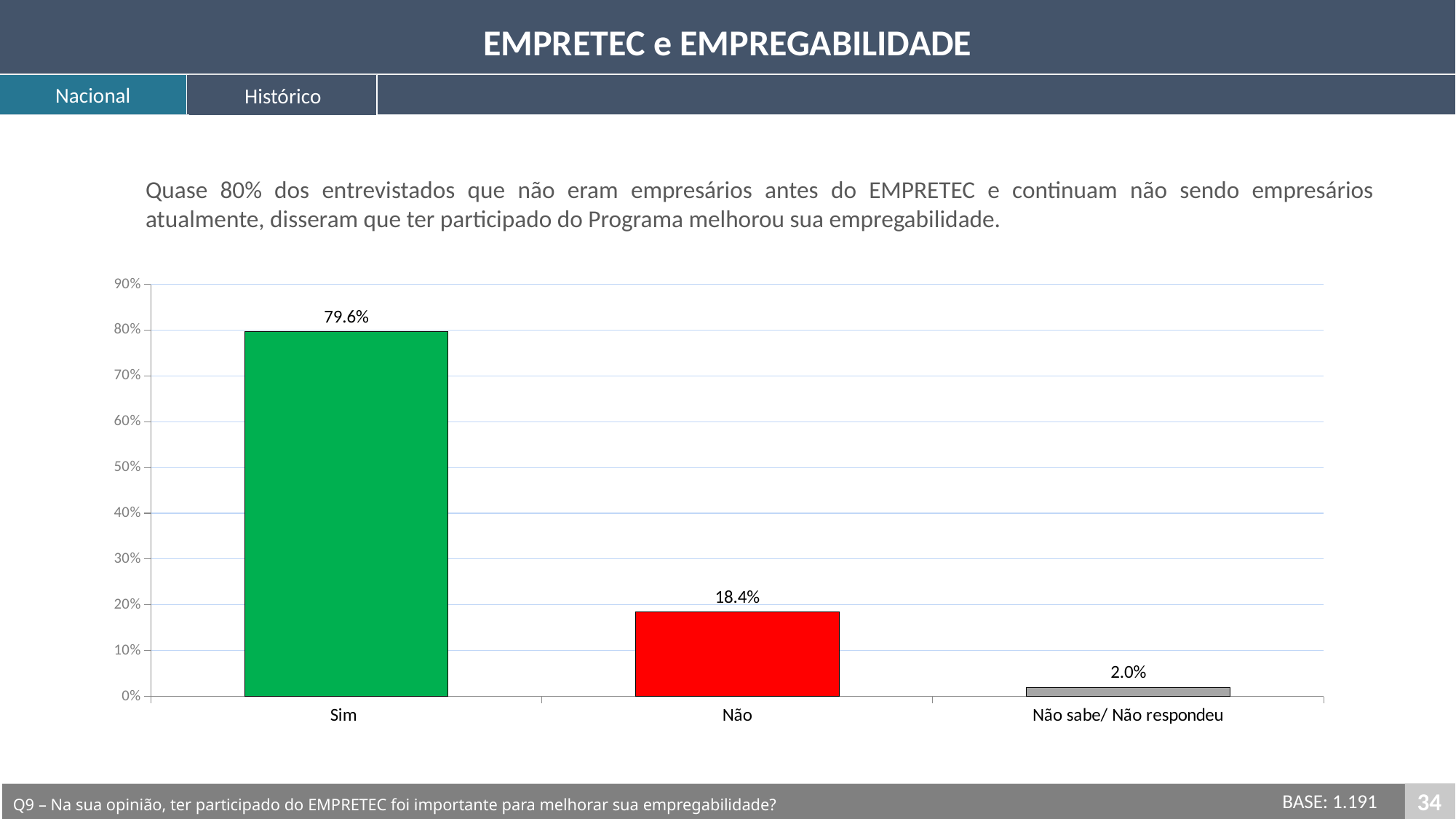
What is the value for Não? 18.4% Which is larger, the value for Não or the value for Não sabe/ Não respondeu? Não Is the value for Não greater or less than 20%? less What kind of chart is shown on the slide? bar chart Which category has the lowest value? Não sabe/ Não respondeu What is the value for Não sabe/ Não respondeu? 2.0% What is the value for Sim? 79.6% What is the difference between the values for Não and Não sabe/ Não respondeu? 16.4% How many categories are shown on the x axis? 3 What is the difference between the values for Sim and Não? 61.2% Which category has the highest value? Sim Is the value for Sim greater or less than 70%? greater